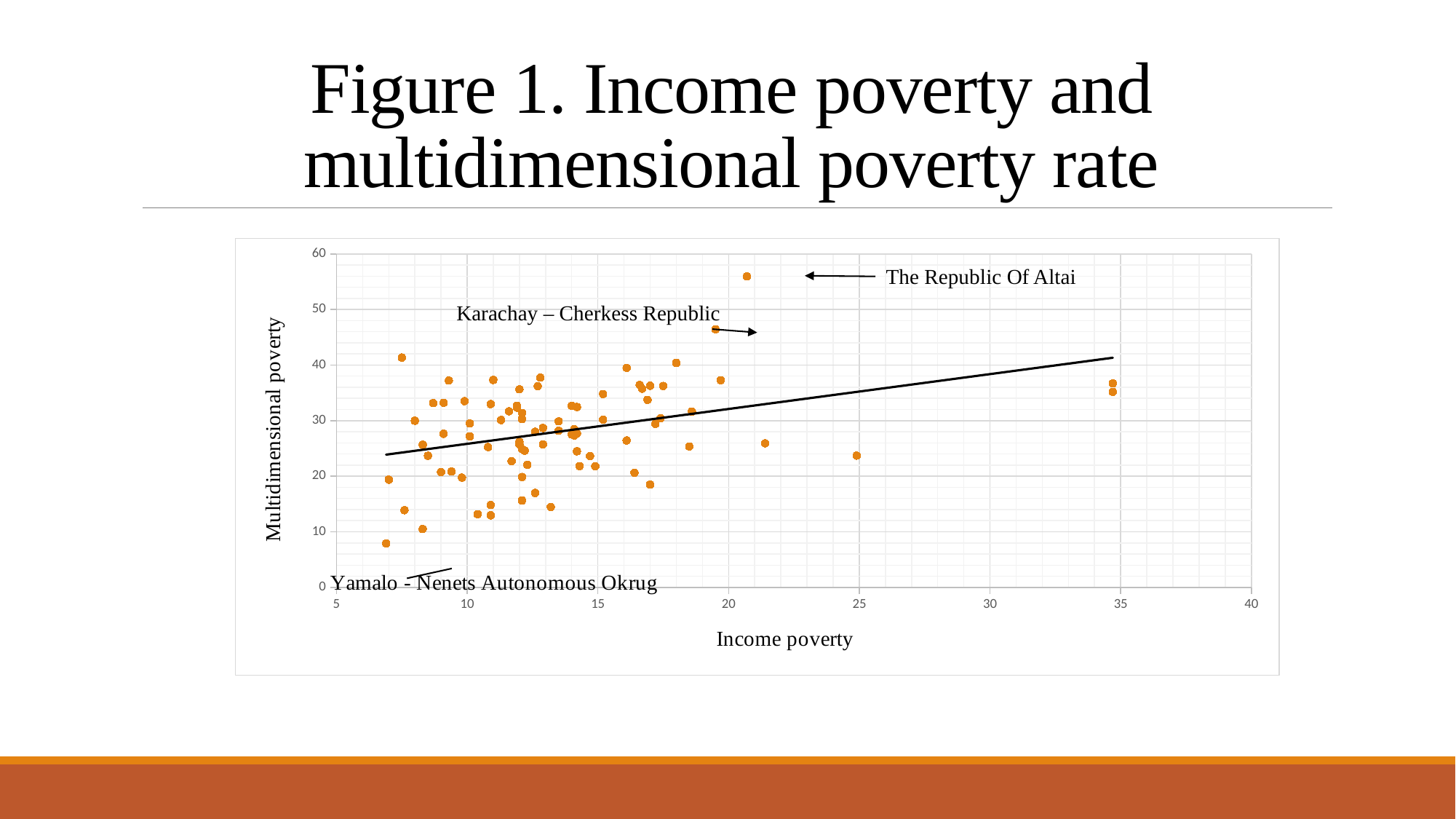
Is the multidimensional poverty value for Karachay – Cherkess Republic greater or less than 40? greater Does the fitted trend line rise or fall as income poverty increases? rises What is the label of the horizontal axis? Income poverty Is the multidimensional poverty value for The Republic Of Altai greater or less than 50? greater What kind of chart is shown on the slide? Scatter plot What is the title of the chart on the slide? Figure 1. Income poverty and multidimensional poverty rate Which labelled region has the highest multidimensional poverty value? The Republic Of Altai Which has the higher multidimensional poverty value, The Republic Of Altai or Karachay – Cherkess Republic? The Republic Of Altai Which labelled region has the lowest multidimensional poverty value? Yamalo - Nenets Autonomous Okrug How many regions are labelled by name on the chart? 3 Is the multidimensional poverty value for Yamalo - Nenets Autonomous Okrug greater or less than 10? less